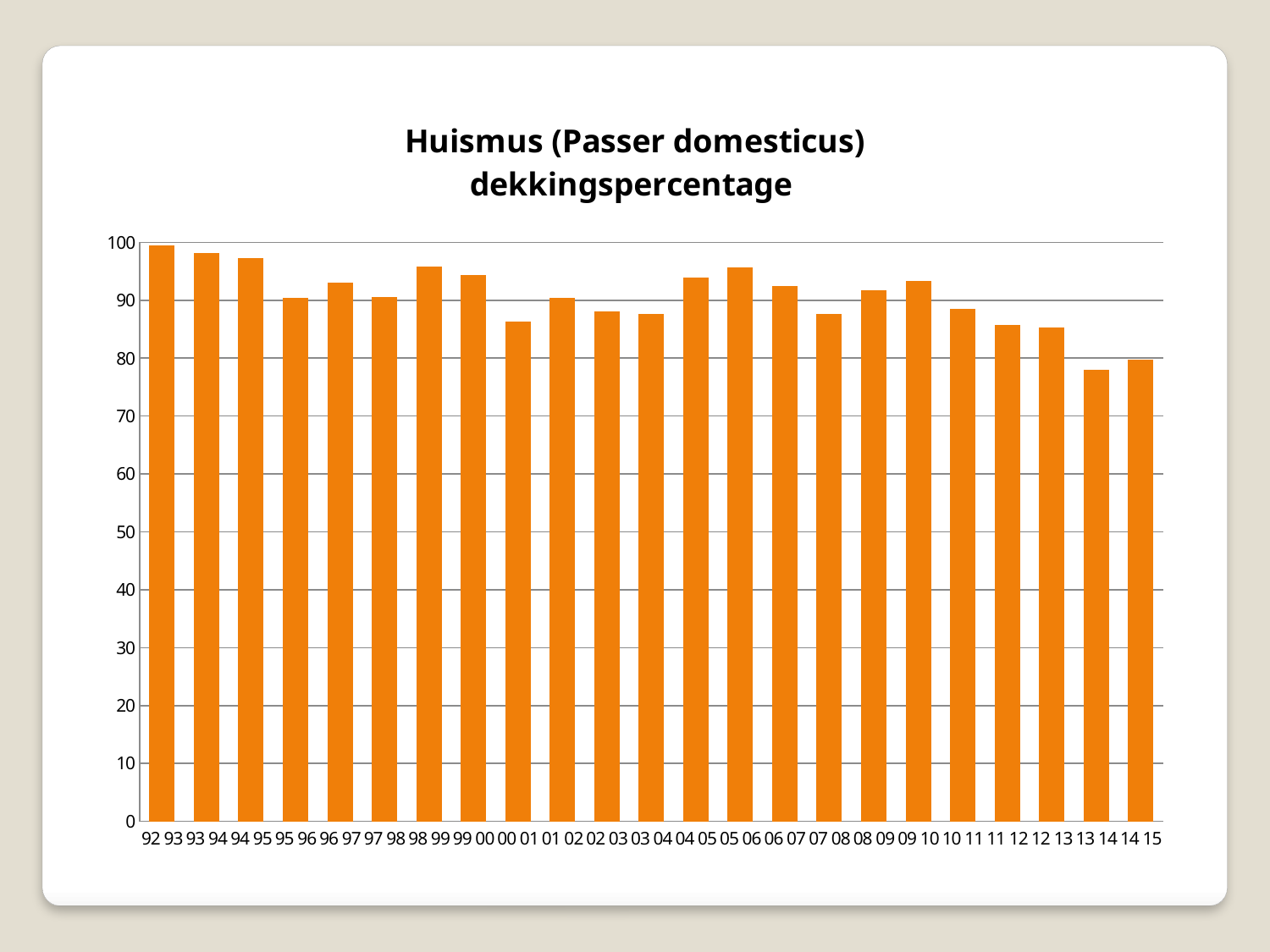
Which is larger, the value for 98 99 or the value for 00 01? 98 99 Is the value for 11 12 greater or less than 90? less Is the value for 13 14 greater or less than 80? less How many bars (seasons) are plotted in the chart? 23 Is the value for 00 01 greater or less than 90? less Which season has the highest bar? 92 93 What kind of chart is shown on the slide? bar chart Which is larger, the value for 92 93 or the value for 13 14? 92 93 What is the title of the chart? Huismus (Passer domesticus) dekkingspercentage Overall, do the values rise or fall from 92 93 to 14 15? fall